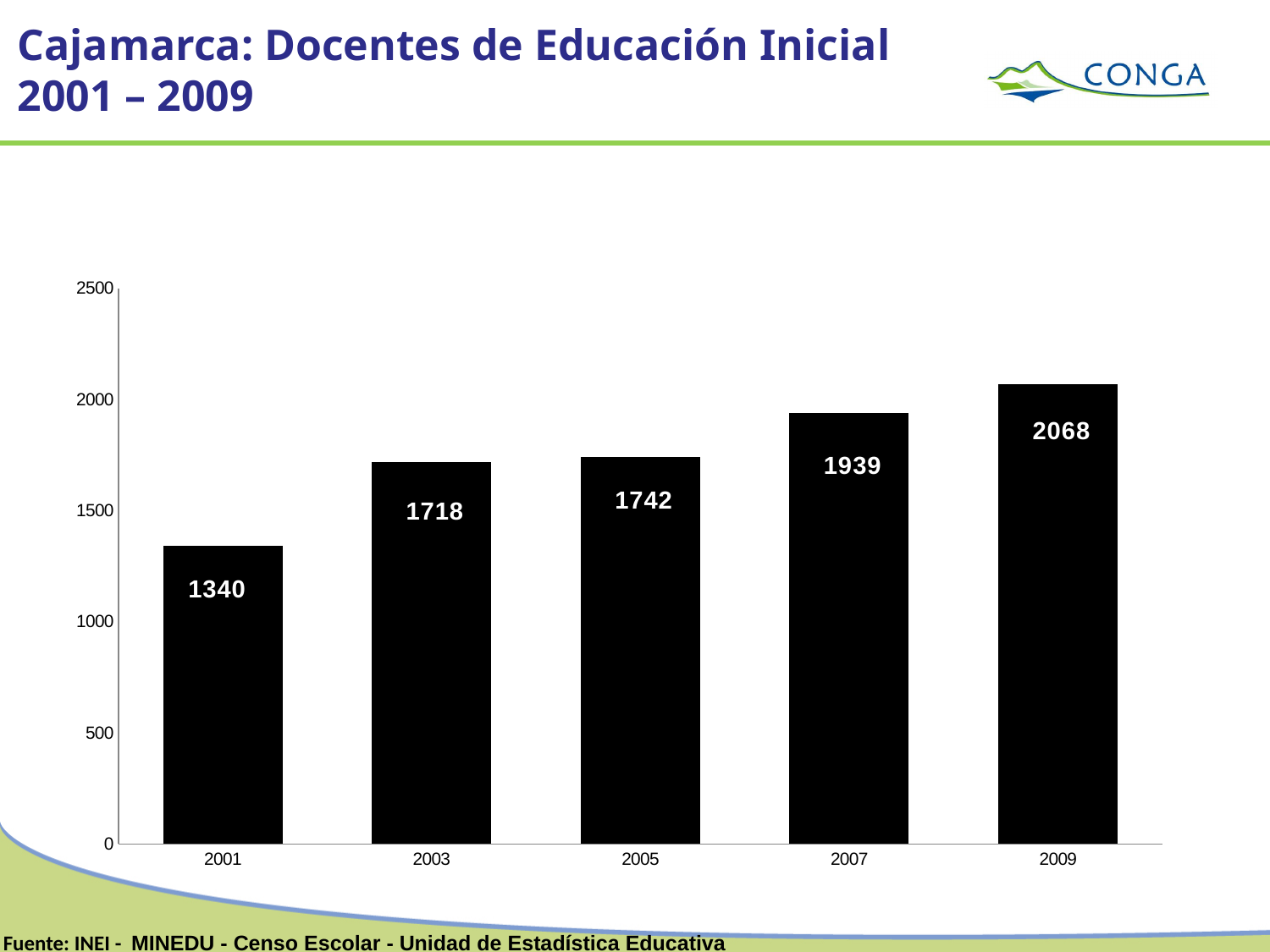
What kind of chart is this? bar chart What is the value for 2007? 1939 How many years are shown on the x axis? 5 Which year has the lowest value? 2001 Do the values rise or fall from 2001 to 2009? rise Is the value for 2009 greater or less than 2000? greater What is the value for 2001? 1340 What is the difference between the values for 2005 and 2003? 24 Which year has the highest value? 2009 What is the difference between the values for 2009 and 2001? 728 Which is larger, the value for 2007 or the value for 2005? 2007 What is the value for 2009? 2068